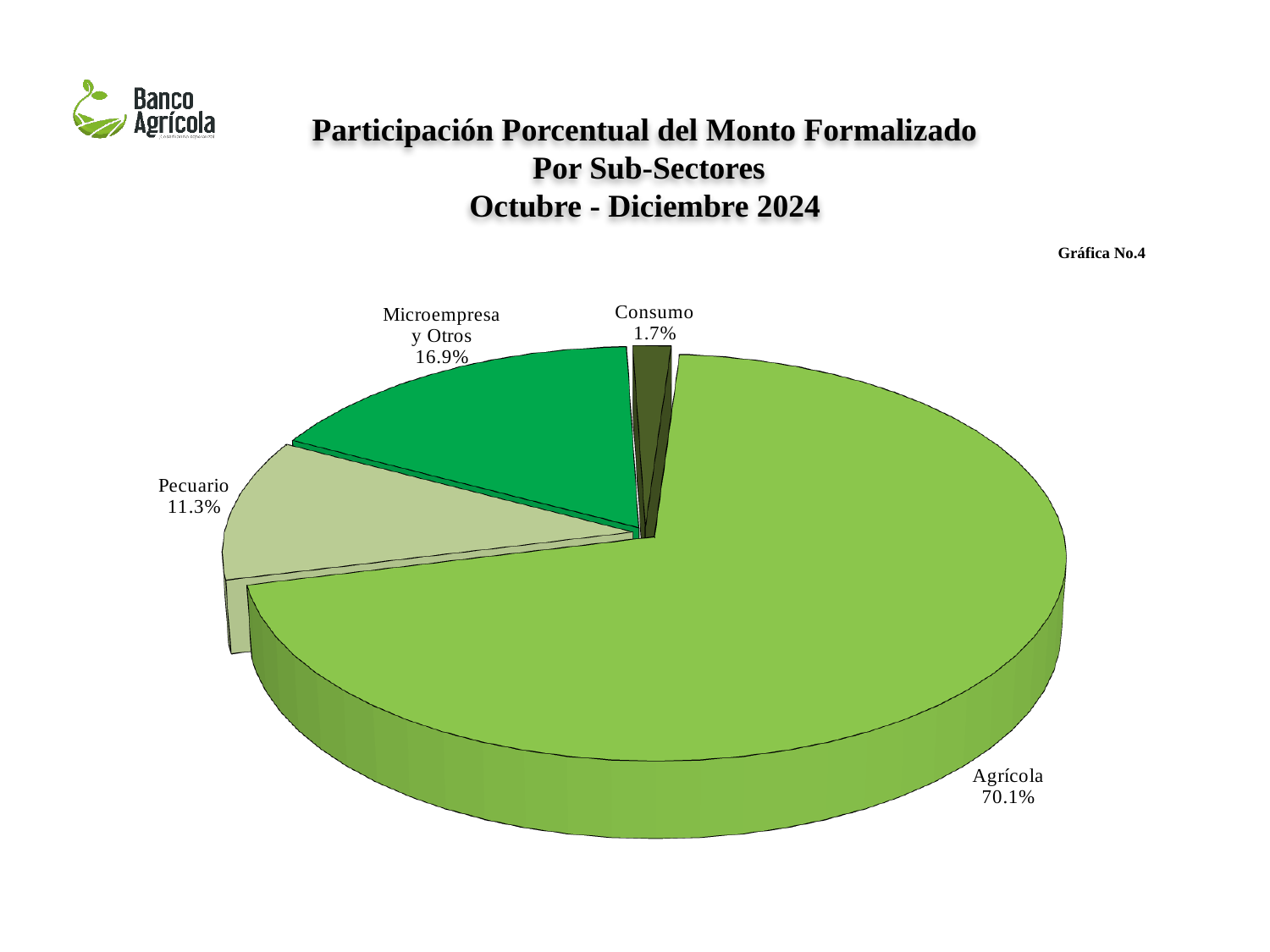
What kind of chart is shown on the slide? Pie chart What is the value shown for Microempresa y Otros? 16.9% What period does the chart title say the data covers? Octubre - Diciembre 2024 What is the difference in percentage points between Microempresa y Otros and Pecuario? 5.6 How many slices does the pie chart have? 4 What share of the pie does Agrícola hold? 70.1% What is the value shown for Consumo? 1.7% Which sub-sector has the smallest share of the pie? Consumo Which is larger, the share for Pecuario or the share for Microempresa y Otros? Microempresa y Otros What is the value shown for Pecuario? 11.3% Which sub-sector has the largest share of the pie? Agrícola What is the difference in percentage points between Agrícola and Consumo? 68.4